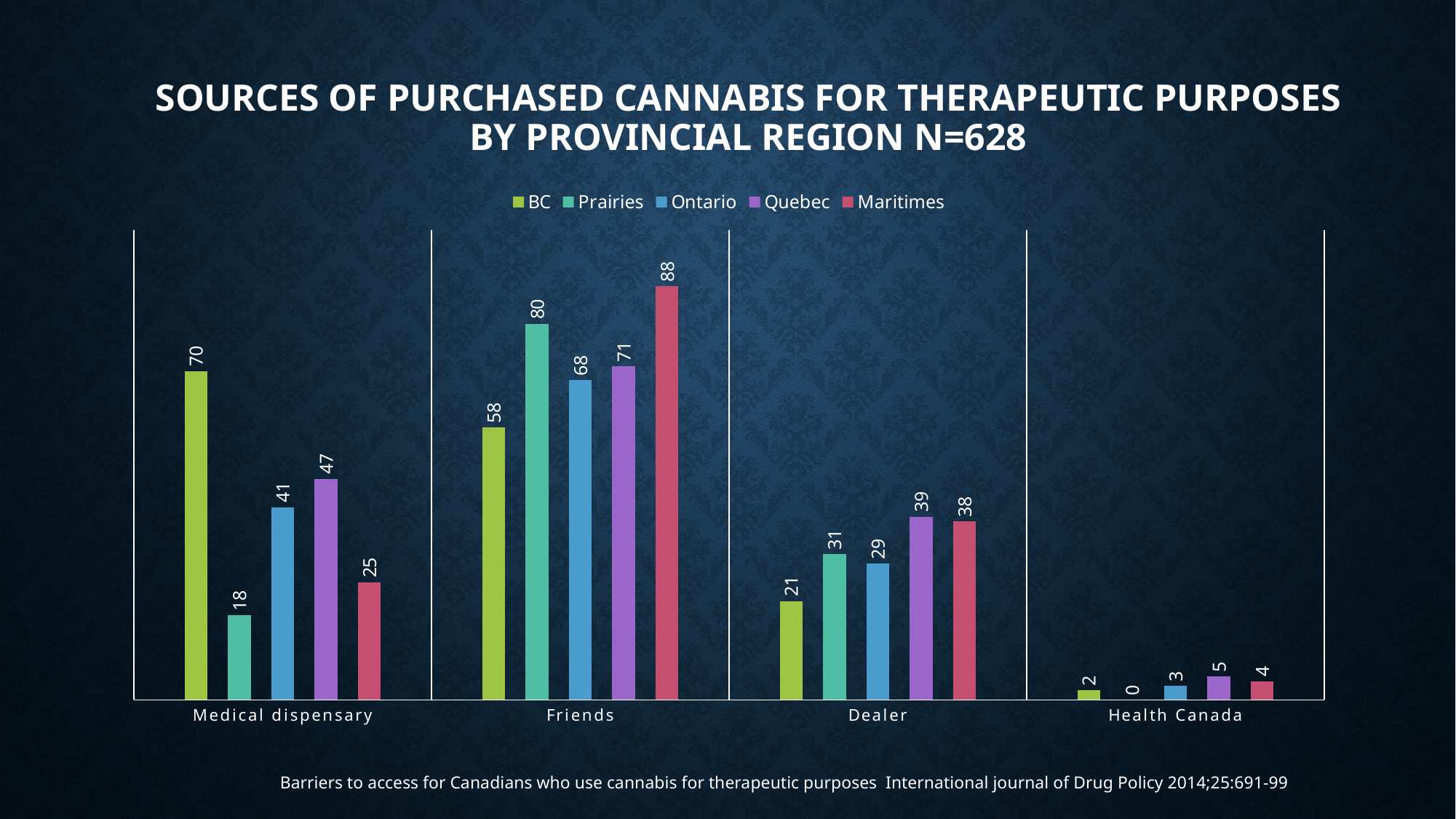
How many source categories are shown on the x axis? 4 Which region has the highest value in the Friends category? Maritimes What is the difference between the Quebec and BC values in the Dealer category? 18 What kind of chart is shown on the slide? Bar chart What is the value for Prairies in the Health Canada category? 0 Which region is shown in purple in the legend? Quebec What is the value for Maritimes in the Friends category? 88 How many series does the legend list? 5 What is the difference between the Prairies and Ontario values in the Friends category? 12 Which region has the lowest value in the Medical dispensary category? Prairies Which is larger in the Medical dispensary category, the value for Ontario or the value for Quebec? Quebec What is the value for BC in the Medical dispensary category? 70